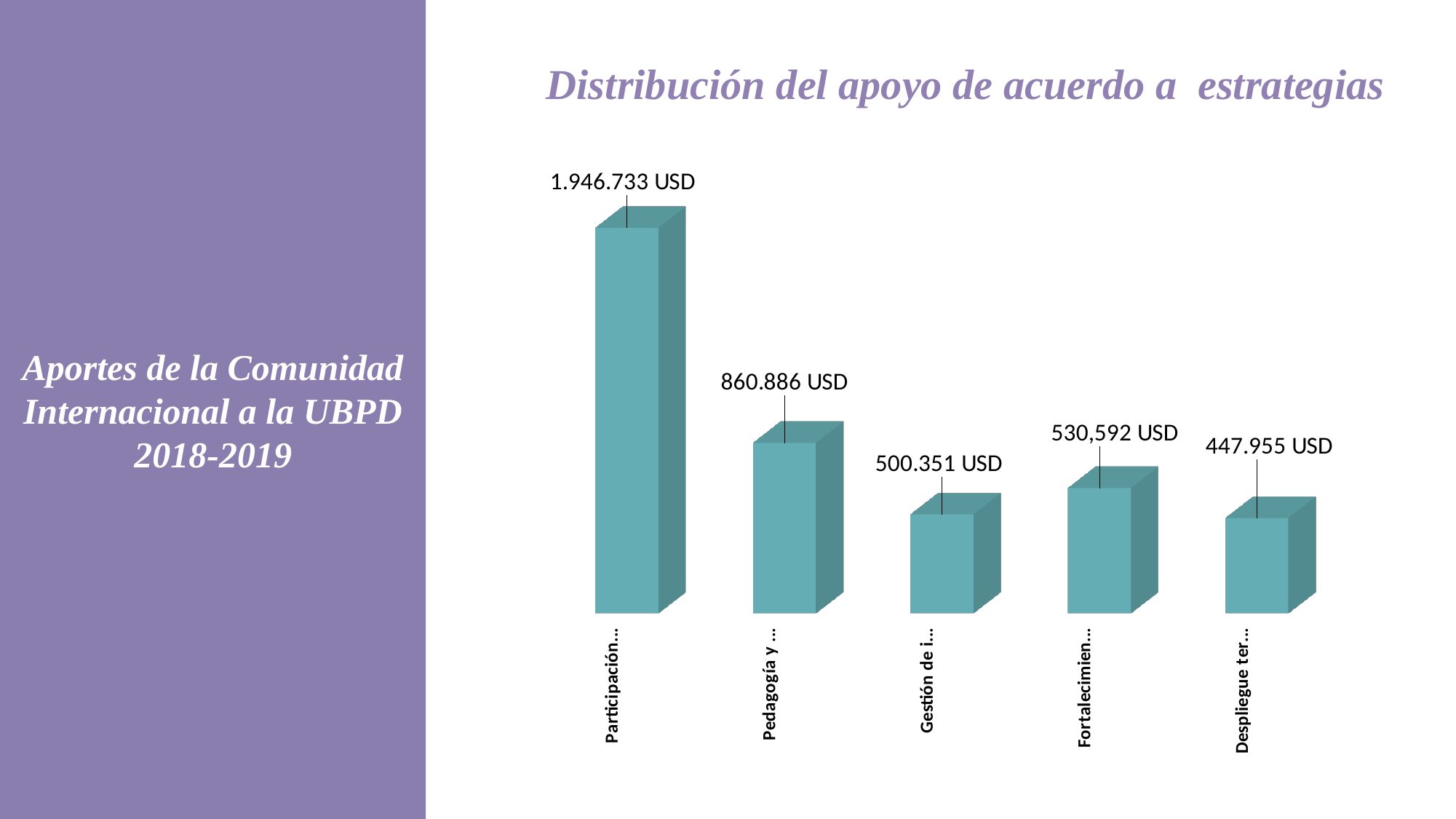
What is the value of the bar labelled "Pedagogía y ..."? 860.886 USD What type of chart is shown on the slide? Bar chart What is the value of the bar labelled "Gestión de i..."? 500.351 USD What is the value of the bar labelled "Fortalecimien..."? 530,592 USD Which category has the highest value? Participación... Which is larger, the value for "Gestión de i..." or the value for "Fortalecimien..."? Fortalecimien... What is the value of the last bar, labelled "Despliegue ter..."? 447.955 USD What is the difference between the value for "Participación..." and the value for "Pedagogía y ..."? 1.085.847 USD What is the title of the chart? Distribución del apoyo de acuerdo a estrategias What is the value of the first bar, labelled "Participación..."? 1.946.733 USD Which category has the lowest value? Despliegue ter... How many bars (categories) does the chart show? 5